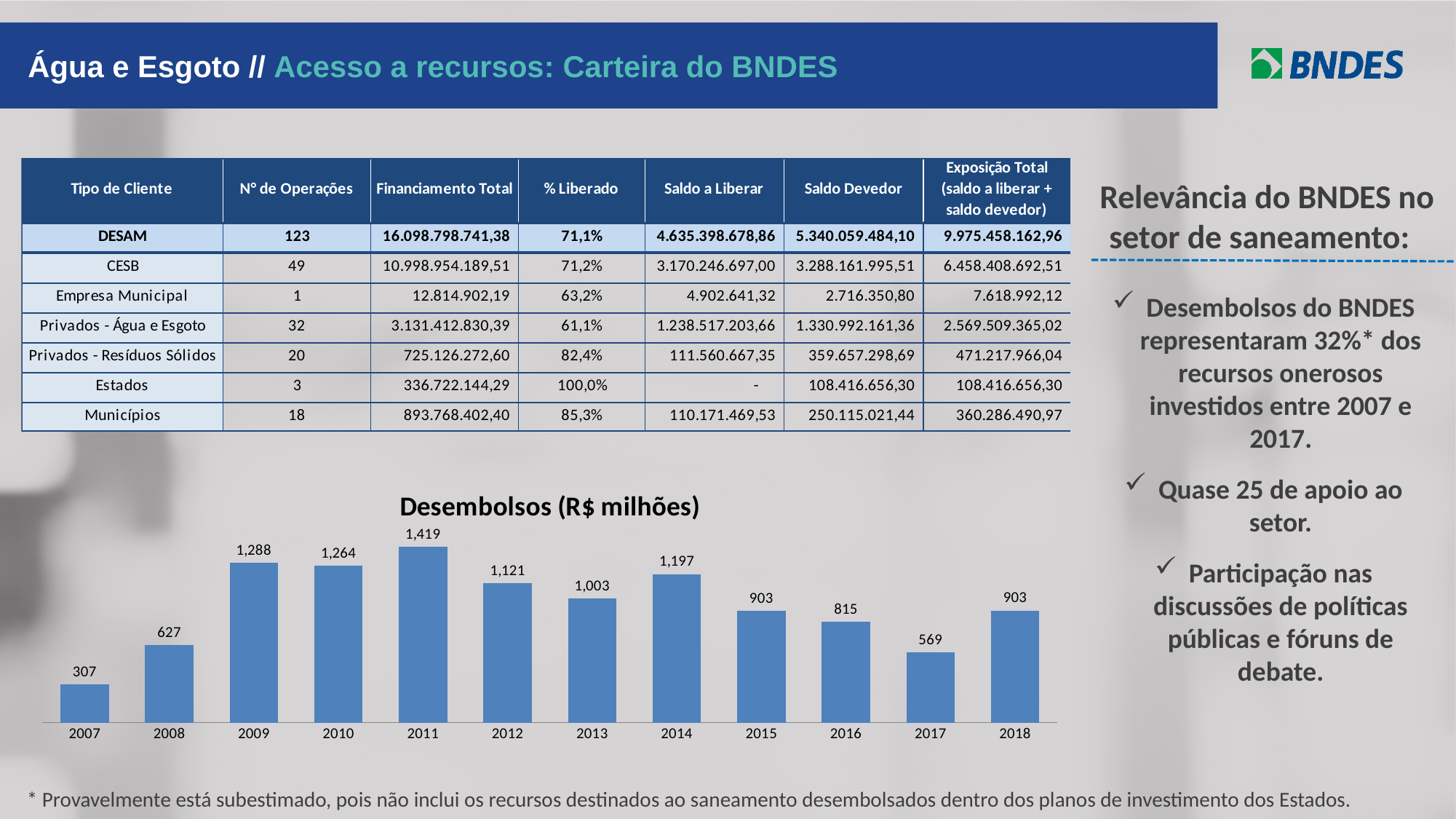
What is the title of the bar chart on the slide? Desembolsos (R$ milhões) Do the values in the Desembolsos (R$ milhões) chart rise or fall from 2014 to 2017? fall Which year has the lowest value in the Desembolsos (R$ milhões) chart? 2007 What kind of chart is the Desembolsos (R$ milhões) chart? bar chart How many years are shown in the Desembolsos (R$ milhões) chart? 12 Which year has the highest value in the Desembolsos (R$ milhões) chart? 2011 What is the difference between the values for 2018 and 2017 in the Desembolsos (R$ milhões) chart? 334 Which is larger in the Desembolsos (R$ milhões) chart, the value for 2012 or the value for 2014? 2014 What is the difference between the values for 2009 and 2010 in the Desembolsos (R$ milhões) chart? 24 What is the value for 2017 in the Desembolsos (R$ milhões) chart? 569 What is the value for 2011 in the Desembolsos (R$ milhões) chart? 1,419 What is the value for 2007 in the Desembolsos (R$ milhões) chart? 307